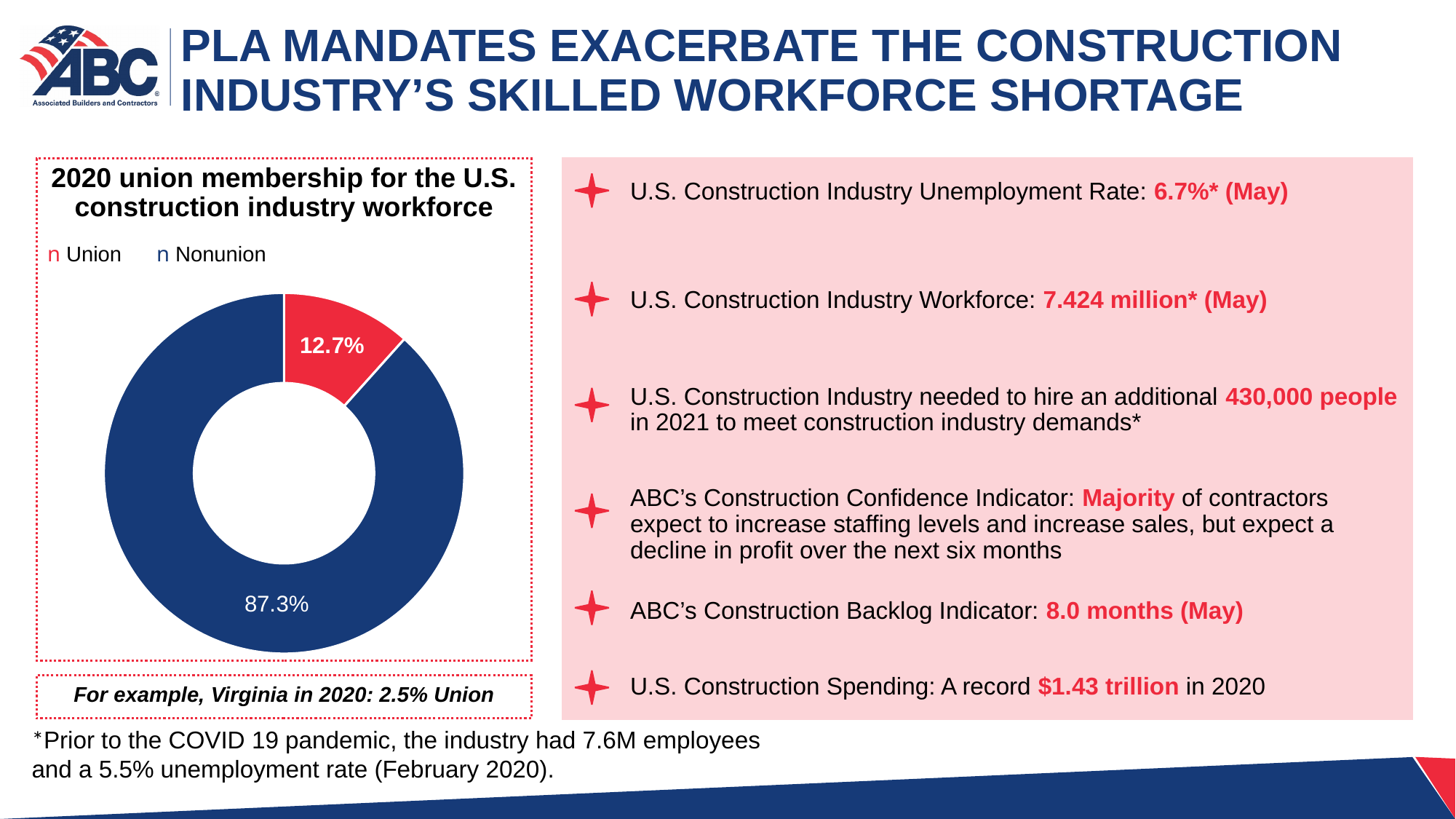
What is the difference in percentage points between the Nonunion and Union shares in the chart? 74.6 Is the Union share larger or smaller than the Nonunion share in the chart? smaller What share of the 2020 U.S. construction industry workforce is Union according to the chart? 12.7% How many entries does the legend of the union membership chart list? 2 How many categories does the union membership chart show? 2 What share of the 2020 U.S. construction industry workforce is Nonunion according to the chart? 87.3% Which colour represents the Union category in the chart? Red Which category has the smallest share in the union membership chart? Union What is the title of the chart on the slide? 2020 union membership for the U.S. construction industry workforce Is the Union share in the chart greater or less than 50%? less Which category has the largest share in the union membership chart? Nonunion What kind of chart is used to show 2020 union membership for the U.S. construction industry workforce? Doughnut (pie) chart